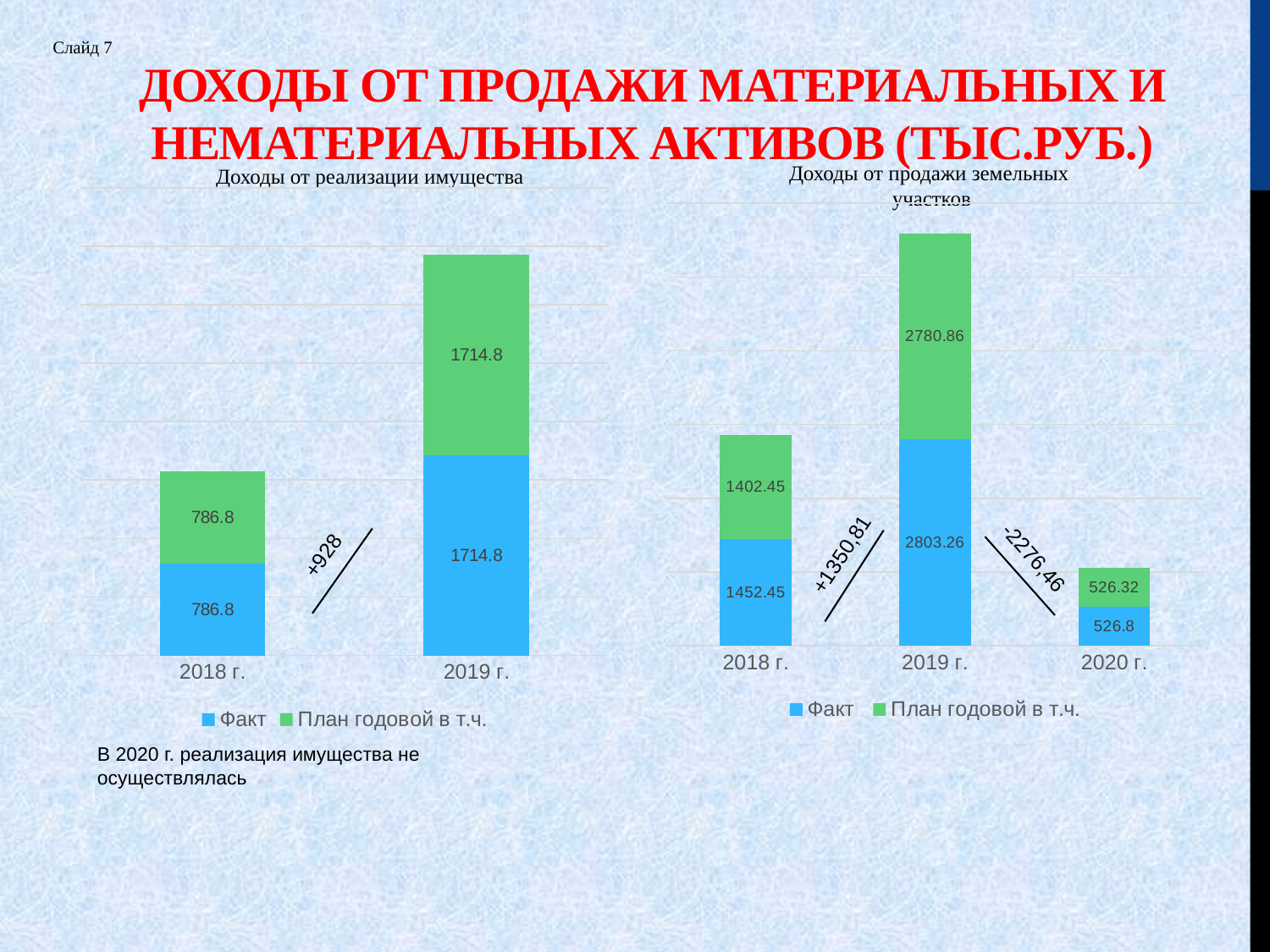
In the chart 'Доходы от реализации имущества', what is the План годовой в т.ч. value for 2018 г.? 786.8 What type of chart is 'Доходы от реализации имущества'? Stacked bar chart How many series does the legend of the chart 'Доходы от реализации имущества' list? 2 In the chart 'Доходы от реализации имущества', what is the difference between the Факт values for 2019 г. and 2018 г.? 928 How many years are shown in the chart 'Доходы от продажи земельных участков'? 3 In the chart 'Доходы от продажи земельных участков', what is the План годовой в т.ч. value for 2020 г.? 526.32 In the chart 'Доходы от продажи земельных участков', which year has the highest Факт value? 2019 г. In the chart 'Доходы от продажи земельных участков', what is the total of the stacked bar for 2020 г.? 1053.12 In the chart 'Доходы от реализации имущества', what is the Факт value for 2019 г.? 1714.8 In the chart 'Доходы от продажи земельных участков', what is the Факт value for 2019 г.? 2803.26 In the chart 'Доходы от продажи земельных участков', which is larger for 2018 г.: the Факт value or the План годовой в т.ч. value? Факт In the chart 'Доходы от продажи земельных участков', which year has the lowest Факт value? 2020 г.